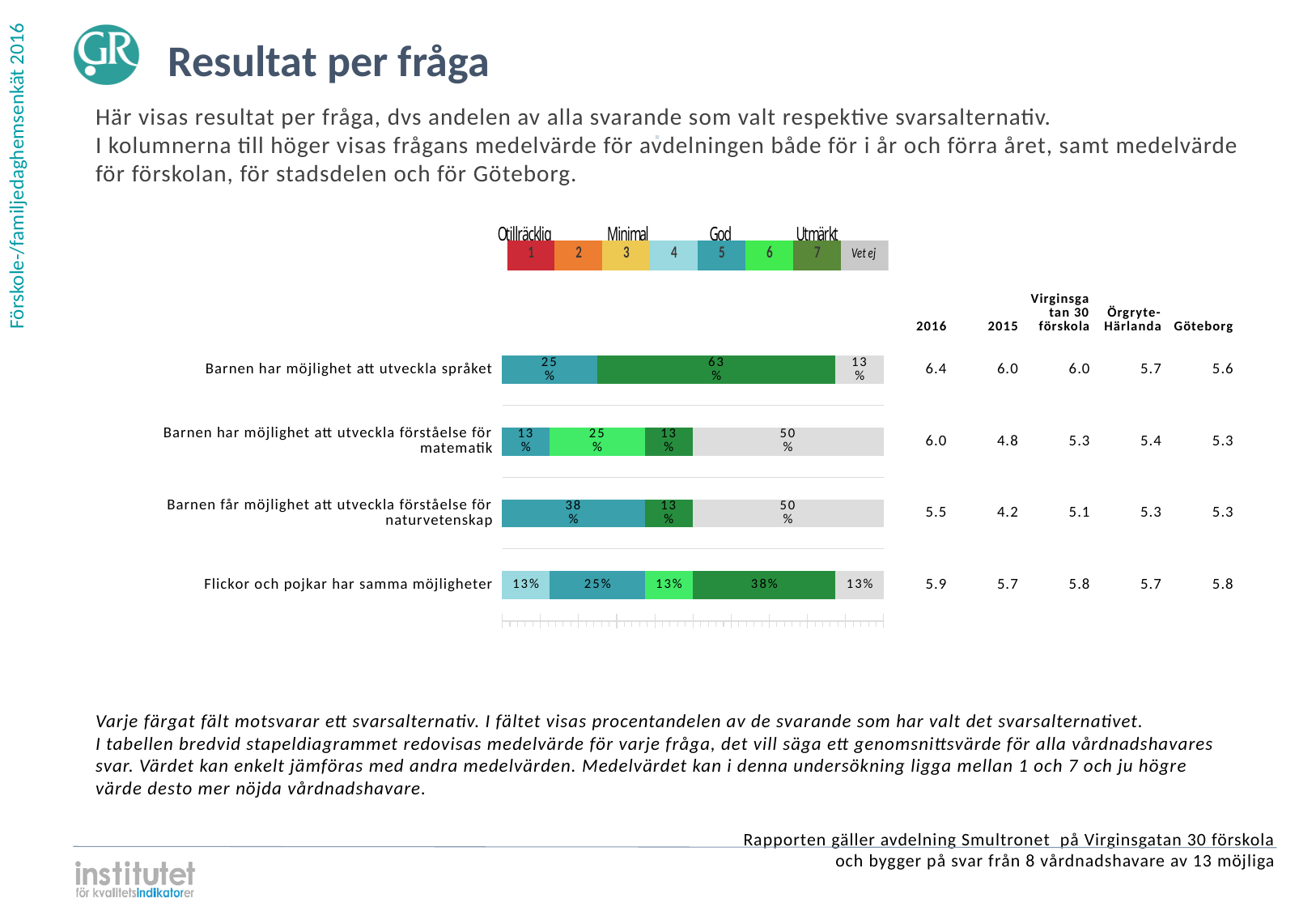
What percentage chose rating 7 (dark green) for 'Flickor och pojkar har samma möjligheter'? 38% What percentage chose 'Vet ej' for 'Barnen får möjlighet att utveckla förståelse för naturvetenskap'? 50% For 'Barnen får möjlighet att utveckla förståelse för naturvetenskap', which is larger: the 2016 mean or the Göteborg mean? 2016 mean What percentage chose the highest rating 7 (dark green) for 'Barnen har möjlighet att utveckla språket'? 63% What is the 2016 mean value for 'Barnen har möjlighet att utveckla språket'? 6.4 Which question has the highest 2016 mean value in the table? Barnen har möjlighet att utveckla språket How many questions (categories) are plotted in the bar chart? 4 What is the difference between the 2016 and 2015 mean values for 'Barnen har möjlighet att utveckla förståelse för matematik'? 1.2 What kind of chart is shown on the slide? Stacked bar chart Which question has the lowest 2015 mean value in the table? Barnen får möjlighet att utveckla förståelse för naturvetenskap How many response options does the colour legend above the chart list, including 'Vet ej'? 8 What percentage of respondents chose 'Vet ej' (grey) for 'Barnen har möjlighet att utveckla språket'? 13%